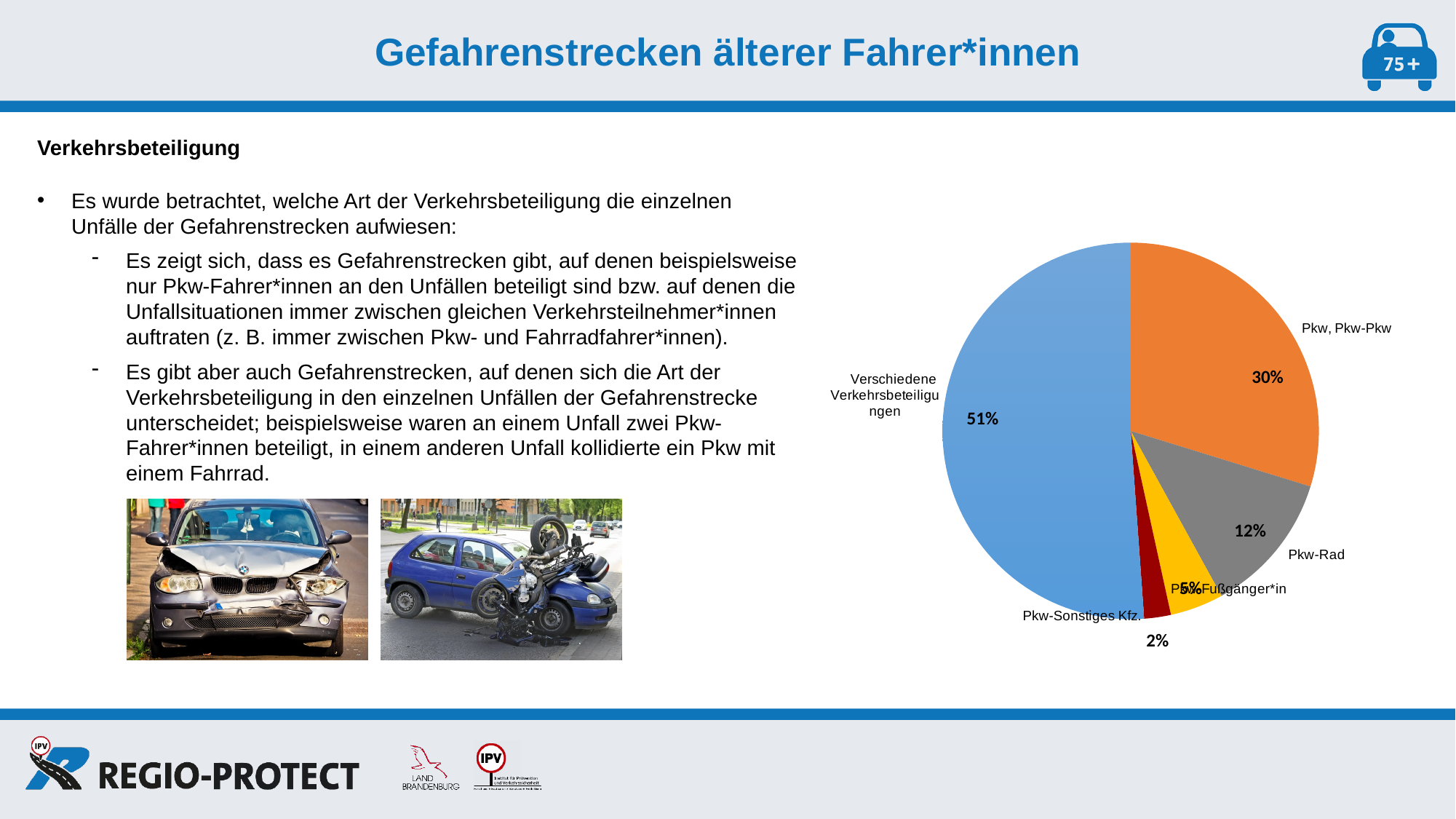
Which category has the largest slice of the pie? Verschiedene Verkehrsbeteiligungen How many slices does the pie chart have? 5 Which is larger, the slice for "Pkw-Rad" or the slice for "Pkw-Fußgänger*in"? Pkw-Rad What share of the pie does "Verschiedene Verkehrsbeteiligungen" have? 51% What is the value shown for "Pkw-Rad"? 12% What is the value shown for "Pkw, Pkw-Pkw"? 30% What is the value shown for "Pkw-Sonstiges Kfz."? 2% What colour is the slice for "Verschiedene Verkehrsbeteiligungen"? blue What is the difference in percentage points between "Pkw, Pkw-Pkw" and "Pkw-Rad"? 18 percentage points What kind of chart is shown on the slide? pie chart Which category has the smallest slice of the pie? Pkw-Sonstiges Kfz. What is the difference in percentage points between "Verschiedene Verkehrsbeteiligungen" and "Pkw, Pkw-Pkw"? 21 percentage points